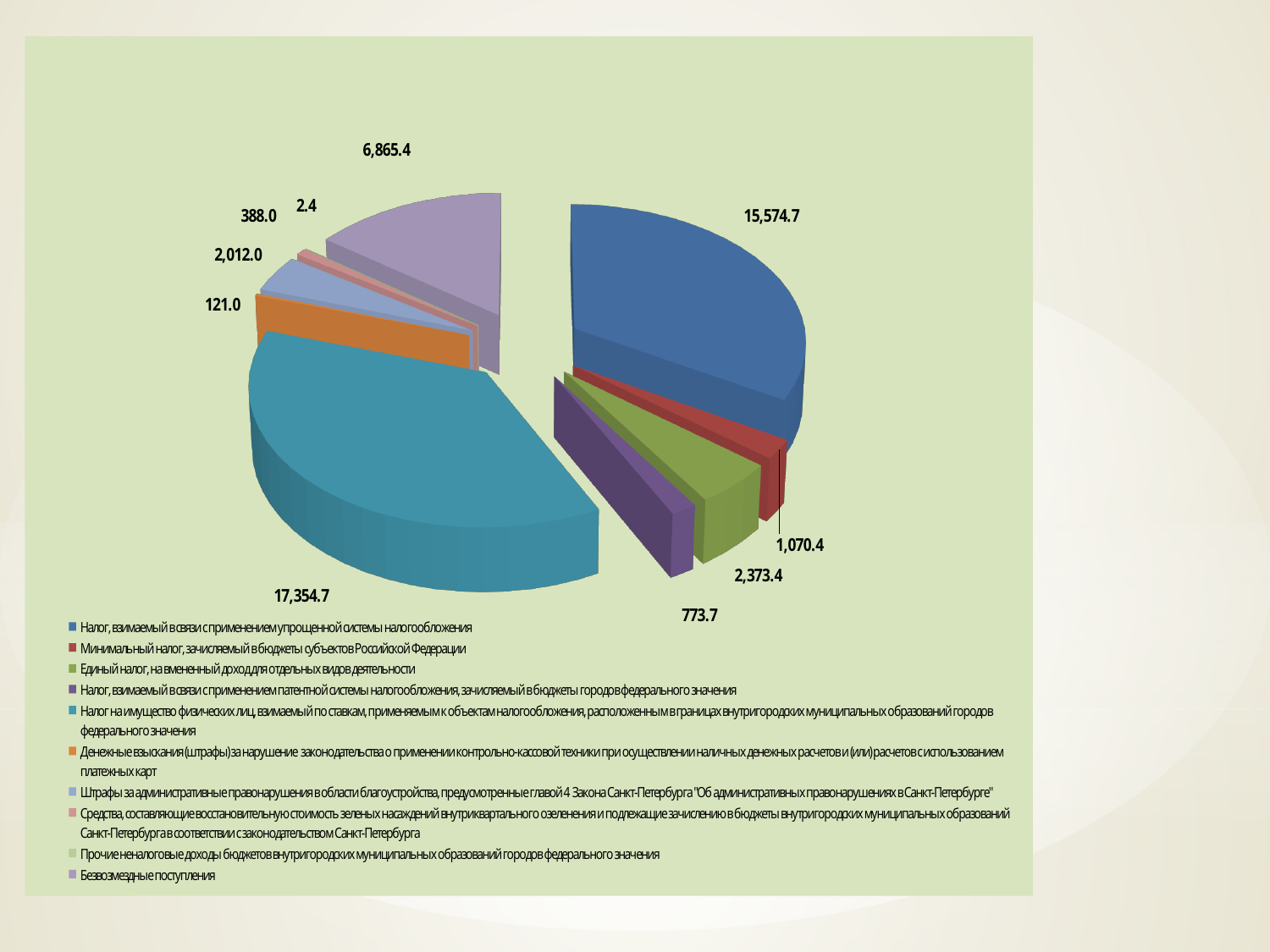
What kind of chart is shown on the slide? pie chart What is the value of the slice for 'Безвозмездные поступления' (the lavender slice)? 6,865.4 What is the value of the slice for 'Налог на имущество физических лиц' (the teal slice)? 17,354.7 What is the difference between the teal slice (17,354.7) and the blue slice (15,574.7)? 1,780.0 How many slices does the pie chart have? 10 Which category has the largest slice in the pie chart? Налог на имущество физических лиц (17,354.7) Which is larger: the slice for 'Минимальный налог' (red) or the slice for 'Единый налог на вмененный доход' (green)? Единый налог на вмененный доход (2,373.4) How many entries does the legend list? 10 What is the value of the slice for 'Штрафы за административные правонарушения в области благоустройства' (the light blue slice)? 2,012.0 Which category has the smallest slice in the pie chart? Прочие неналоговые доходы (2.4) What is the value of the slice for 'Единый налог на вмененный доход для отдельных видов деятельности' (the green slice)? 2,373.4 What is the value of the slice for 'Налог, взимаемый в связи с применением упрощенной системы налогообложения' (the blue slice)? 15,574.7